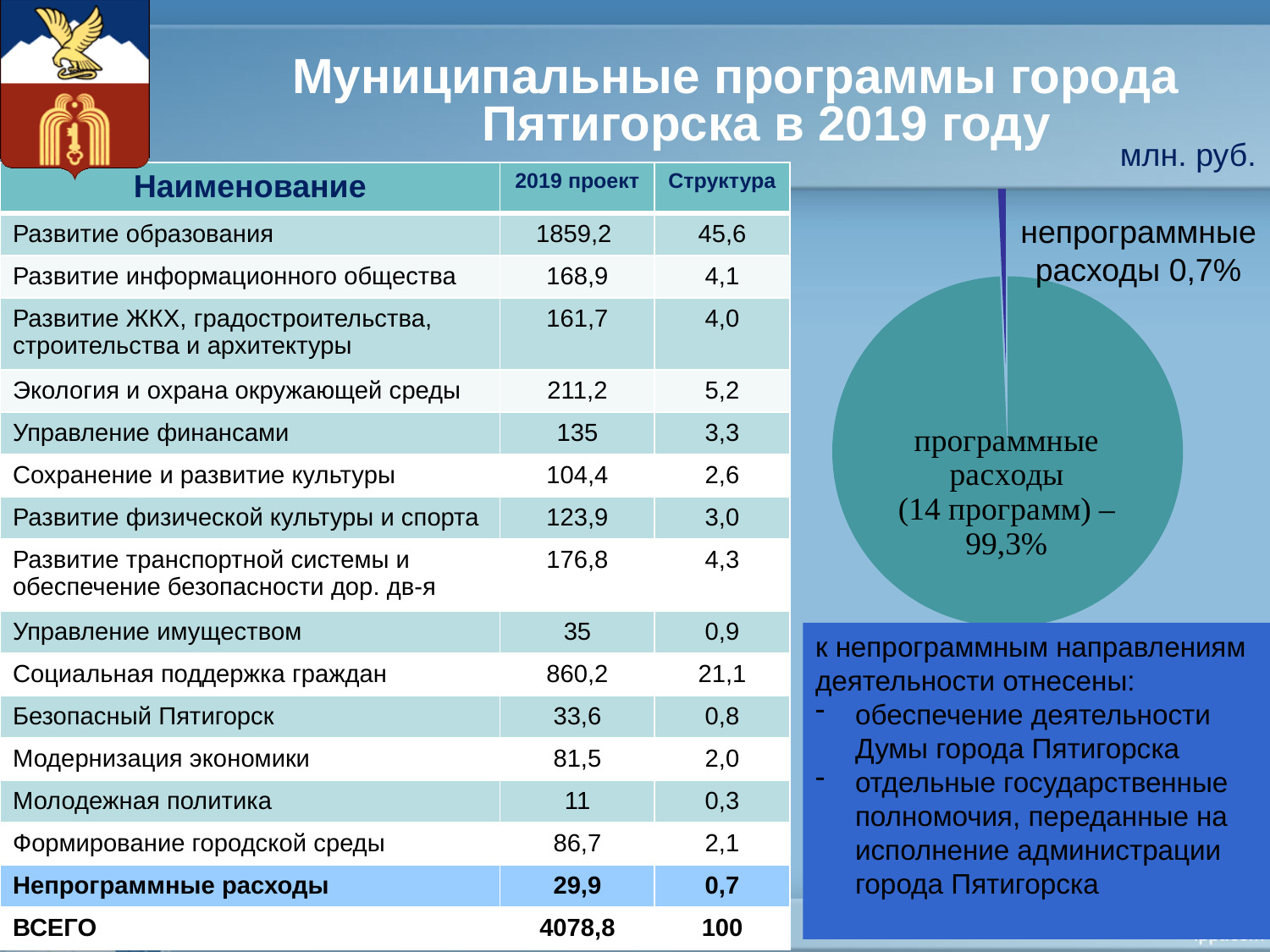
What kind of chart is shown on the right side of the slide? pie chart What unit of measurement is indicated above the pie chart? млн. руб. How many programs are included in the программные расходы slice of the pie chart? 14 Which slice of the pie chart is the smallest? непрограммные расходы How many slices does the pie chart have? 2 What share of the pie chart is taken by непрограммные расходы? 0,7% What share of the pie chart is taken by программные расходы? 99,3% Is the share of непрограммные расходы in the pie chart greater or less than 1%? less Which slice of the pie chart is the largest? программные расходы What is the difference in percentage points between the программные расходы slice and the непрограммные расходы slice in the pie chart? 98,6 In the pie chart, which is larger: программные расходы or непрограммные расходы? программные расходы